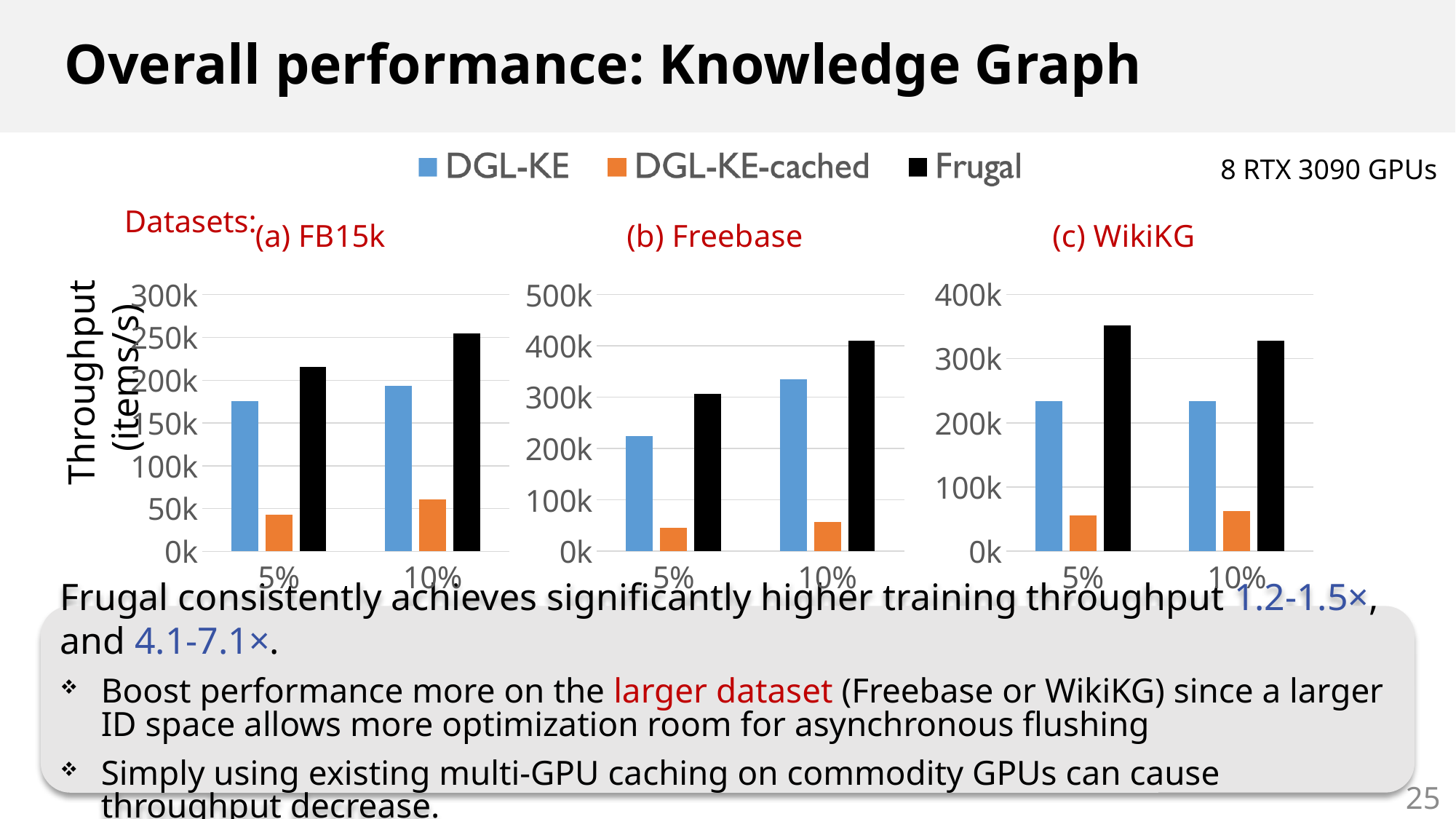
In chart (c) WikiKG, is the value for DGL-KE-cached at 5% greater or less than 100k? less What kind of chart is used for (a) FB15k? bar chart In chart (b) Freebase, which series has the lowest throughput at 5%? DGL-KE-cached What colour represents Frugal in the legend? black In chart (c) WikiKG, is the value for Frugal at 5% greater or less than 300k? greater In chart (b) Freebase, is the value for DGL-KE at 10% greater or less than 300k? greater How many series does the legend list? 3 In chart (b) Freebase, does the Frugal throughput rise or fall from 5% to 10%? rise In chart (a) FB15k, how many x-axis categories are shown? 2 In chart (a) FB15k, which series has the highest throughput at 10%? Frugal In chart (c) WikiKG, is the Frugal value larger at 5% or at 10%? 5%